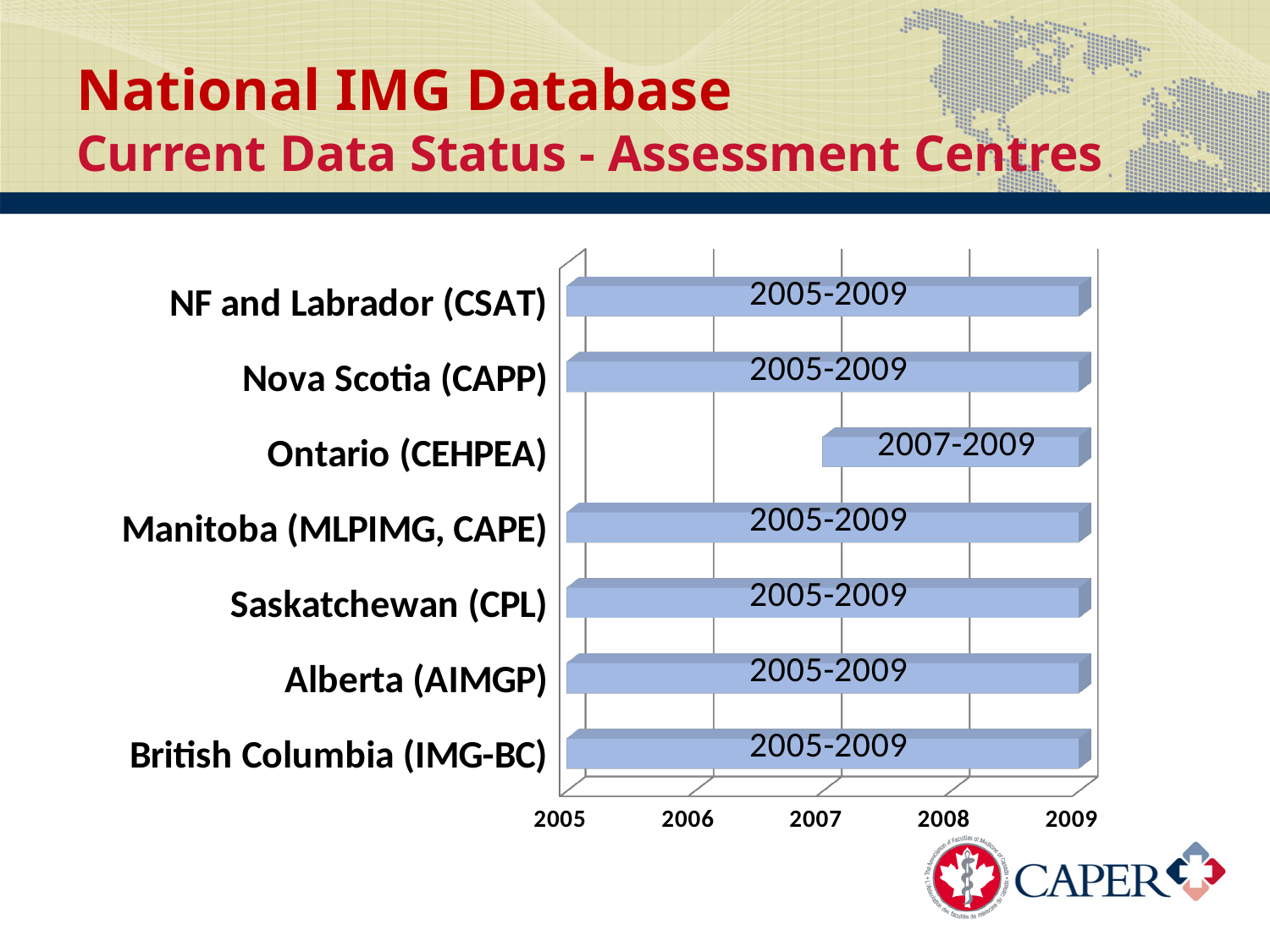
How many assessment centres (categories) are listed on the chart? 7 What kind of chart is shown on the slide? bar chart Which assessment centre has the shortest bar on the chart? Ontario (CEHPEA) How many assessment centres have a data label of 2005-2009? 6 What data label is shown on the bar for Manitoba (MLPIMG, CAPE)? 2005-2009 What data label is shown on the bar for British Columbia (IMG-BC)? 2005-2009 Is the bar for Alberta (AIMGP) longer or shorter than the bar for Ontario (CEHPEA)? longer Which assessment centre's data coverage starts latest? Ontario (CEHPEA) What data label is shown on the bar for Nova Scotia (CAPP)? 2005-2009 What is the first year shown on the horizontal axis? 2005 What data label is shown on the bar for Ontario (CEHPEA)? 2007-2009 What is the last year shown on the horizontal axis? 2009